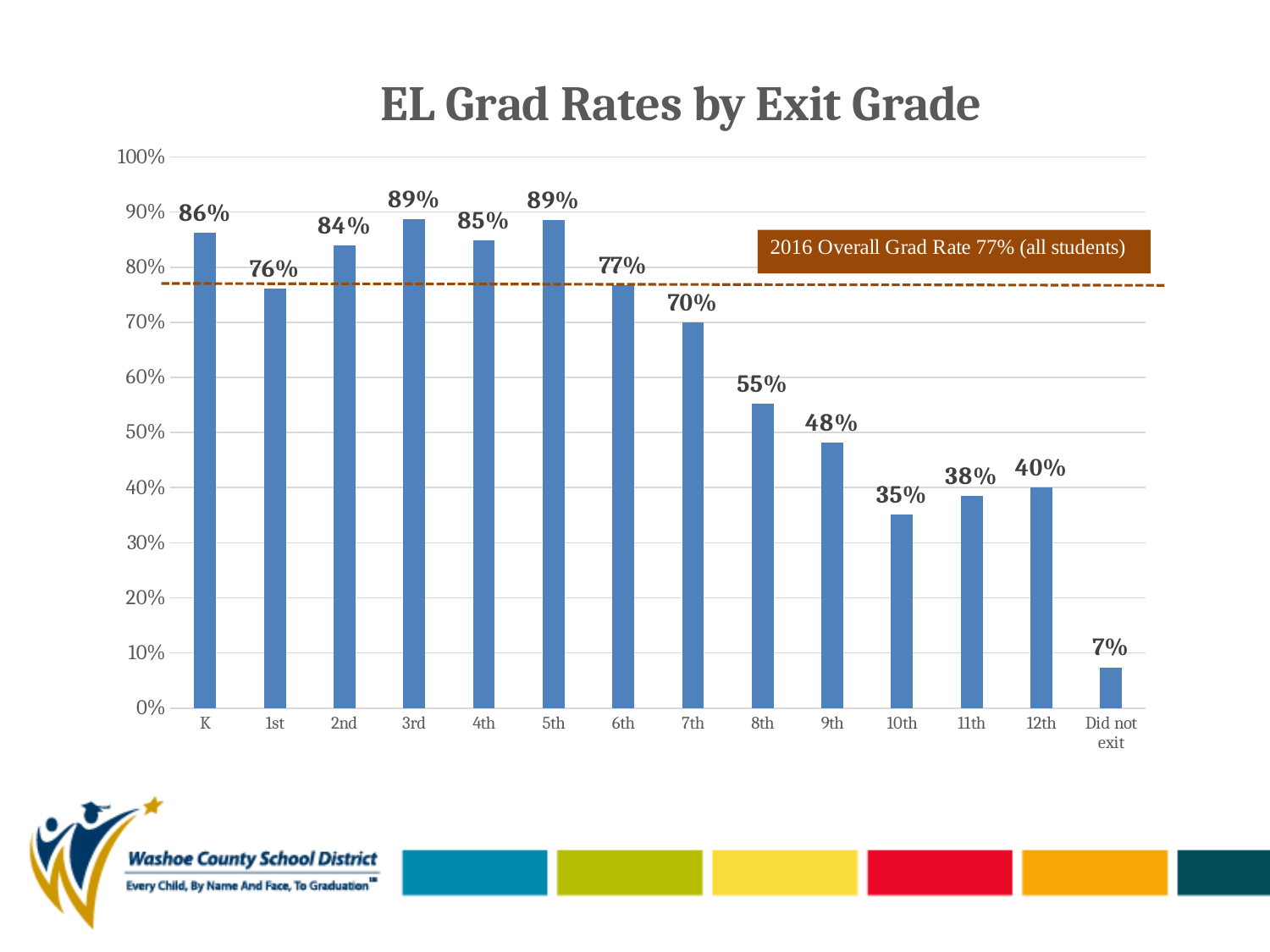
Do the EL grad rates generally rise or fall from 5th grade exit to 10th grade exit? Fall What kind of chart is shown on the slide? Bar chart How many exit grade categories are shown on the chart? 14 What is the difference between the EL grad rate for 6th grade exit and 9th grade exit? 29% What is the 2016 overall grad rate for all students shown by the dashed line? 77% What is the title of the chart? EL Grad Rates by Exit Grade What is the difference between the EL grad rate for K exit and 12th grade exit? 46% Which has a higher EL grad rate: 7th grade exit or 8th grade exit? 7th What is the EL grad rate for students who exited in 3rd grade? 89% Which exit grade has the lowest EL grad rate? Did not exit What is the EL grad rate for students who did not exit? 7% What is the EL grad rate for students who exited in 10th grade? 35%